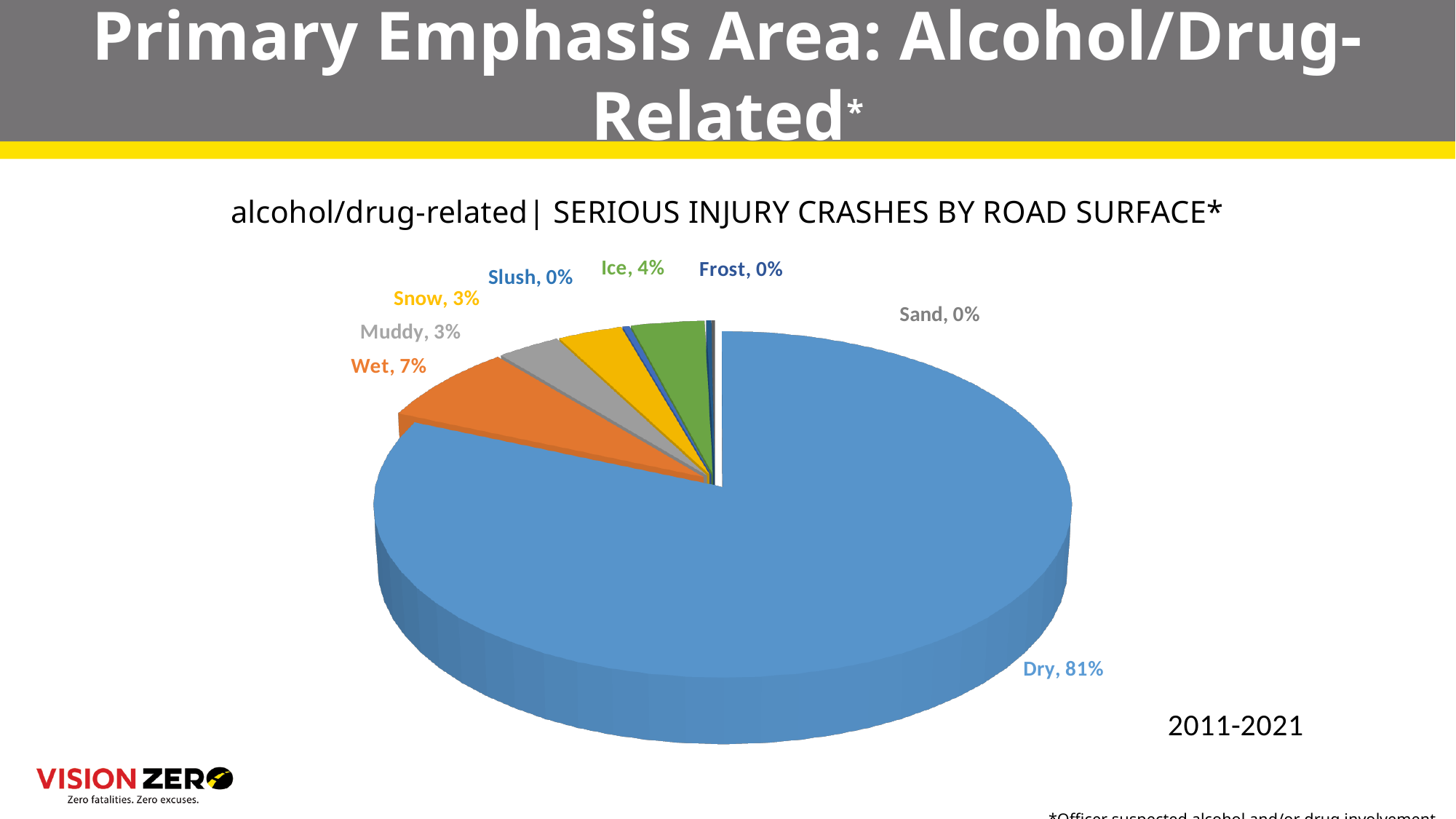
What is the title of the chart? alcohol/drug-related| SERIOUS INJURY CRASHES BY ROAD SURFACE* What type of chart is shown on the slide? Pie chart How many road surface categories are labelled on the pie chart? 8 What percentage is shown for the Muddy road surface? 3% What percentage is shown for the Wet road surface? 7% What percentage is shown for the Snow road surface? 3% What is the difference in percentage points between the Dry and Wet slices? 74 Which is larger, the Wet slice or the Ice slice? Wet Which road surface category has the largest share of crashes? Dry What time period does the chart cover? 2011-2021 What percentage is shown for the Ice road surface? 4% What share of alcohol/drug-related serious injury crashes occurred on a Dry road surface? 81%